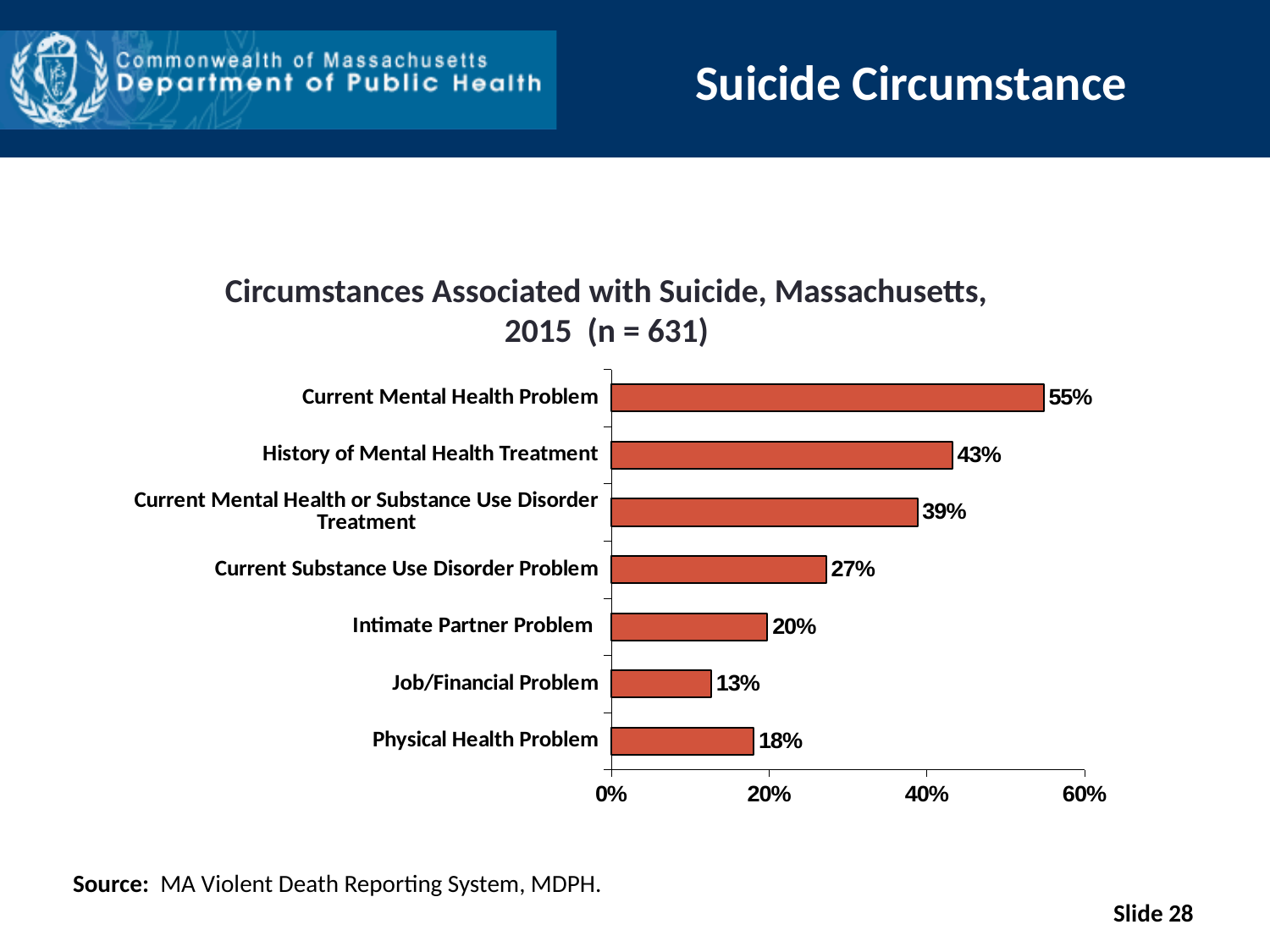
Which is larger: Physical Health Problem or Job/Financial Problem? Physical Health Problem What percentage is shown for Physical Health Problem? 18% Is the value for Current Mental Health or Substance Use Disorder Treatment greater or less than 40%? less What kind of chart is shown on the slide? Bar chart What is the maximum value shown on the x axis? 60% Which circumstance has the highest percentage? Current Mental Health Problem How many circumstances are shown in the chart? 7 What percentage is shown for Current Mental Health Problem? 55% What is the difference between History of Mental Health Treatment and Current Substance Use Disorder Problem? 16% What is the value for Intimate Partner Problem? 20% What is the sample size (n) given in the chart title? 631 Which circumstance has the lowest percentage? Job/Financial Problem